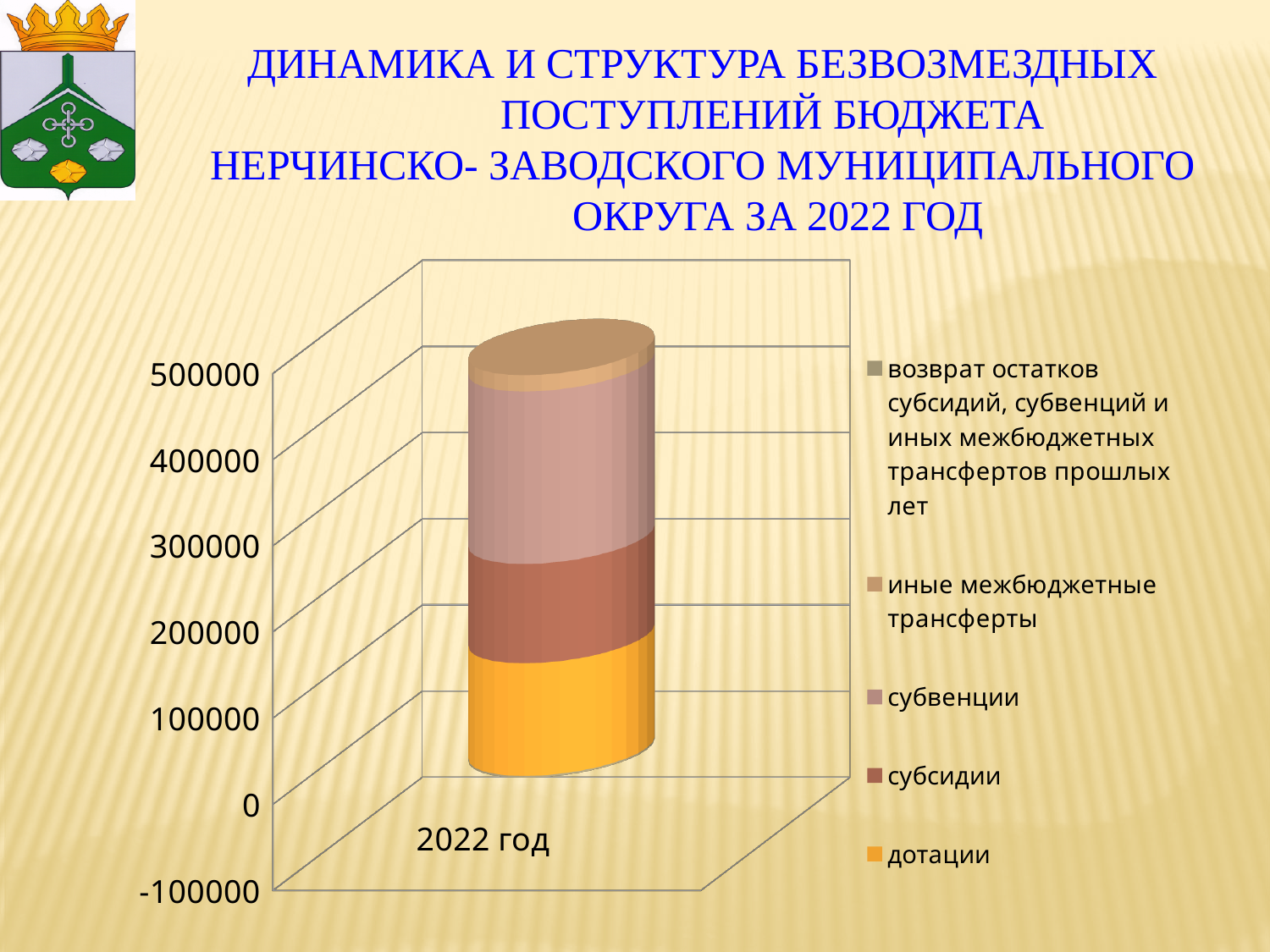
What is the label of the single category on the x axis? 2022 год Which segment is larger in the 2022 год bar: дотации or субсидии? дотации Is the value of the дотации segment for 2022 год greater or less than 300000? less What kind of chart is shown on the slide? Bar chart (stacked) Which series forms the largest segment of the stacked bar for 2022 год? субвенции Which series is listed at the top of the legend? возврат остатков субсидий, субвенций и иных межбюджетных трансфертов прошлых лет How many series does the legend list? 5 Is the total height of the stacked bar for 2022 год greater or less than 300000? greater Which series is listed at the bottom of the legend? дотации How many categories are shown on the x axis of the chart? 1 What is the lowest value shown on the vertical axis? -100000 Which segment is larger in the 2022 год bar: субвенции or субсидии? субвенции